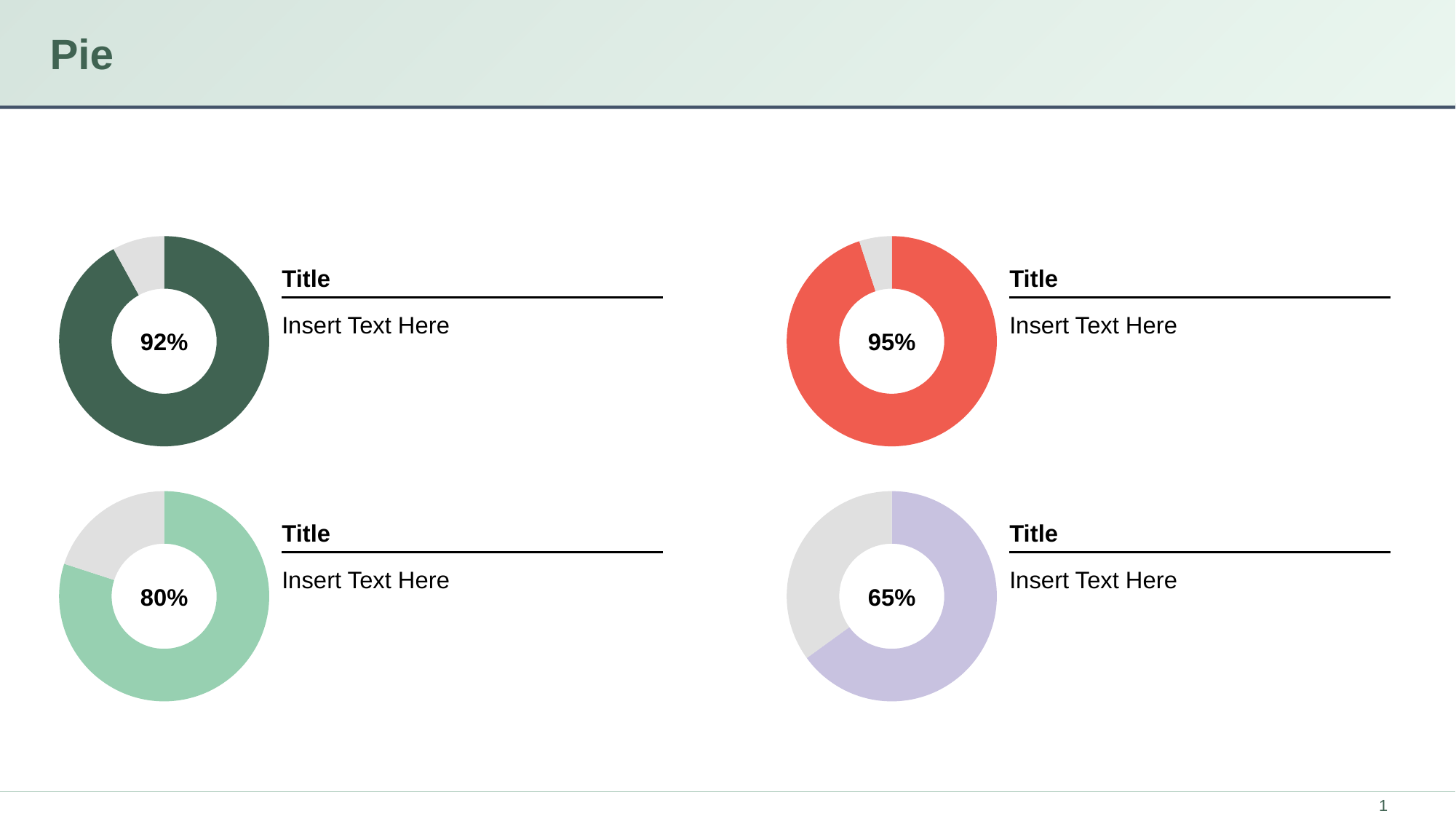
How many donut charts are shown on the slide? 4 What is the difference between the percentage in the top-right donut chart and the percentage in the bottom-right donut chart? 30% What percentage is shown in the centre of the top-left donut chart? 92% What is the difference between the percentage in the top-left donut chart and the percentage in the bottom-left donut chart? 12% Which of the four donut charts on the slide shows the highest percentage? The top-right chart (95%) Which shows a larger percentage, the top-left donut chart or the bottom-left donut chart? The top-left chart What percentage is shown in the centre of the bottom-left donut chart? 80% What percentage is shown in the centre of the top-right donut chart? 95% What colour is the filled portion of the top-right donut chart? Red What percentage is shown in the centre of the bottom-right donut chart? 65% What kind of chart is used for each of the four charts on the slide? Donut (pie) chart Which of the four donut charts on the slide shows the lowest percentage? The bottom-right chart (65%)